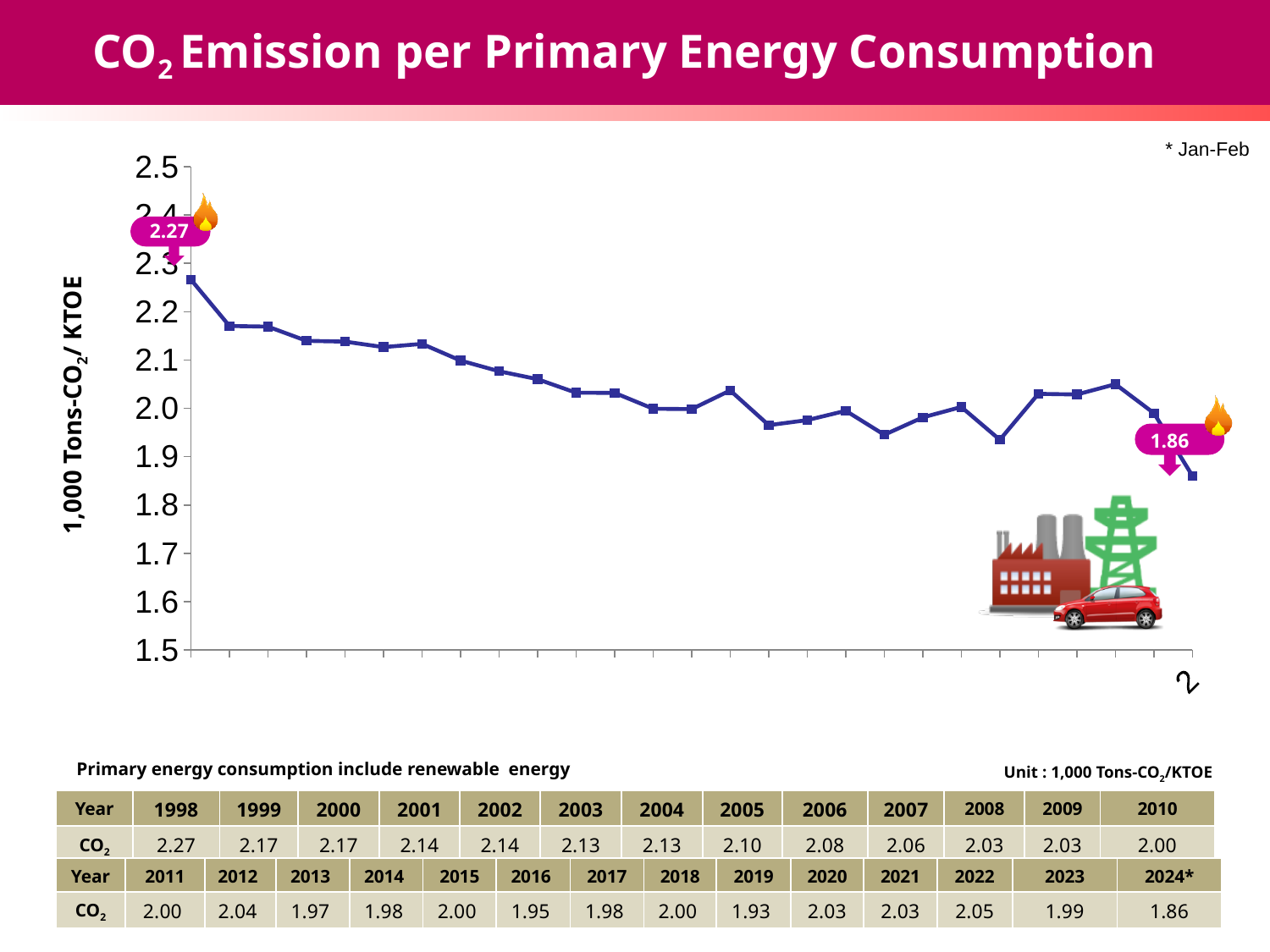
What is the difference between the 1998 value (2.27) and the 2024* value (1.86)? 0.41 Which is larger, the value for 2012 or the value for 2013? 2012 What is the value labelled at the end of the line (2024*)? 1.86 What is the CO2 value for 2005? 2.10 What kind of chart is shown on the slide? line chart Which year has the highest CO2 emission per primary energy consumption? 1998 Does the line generally rise or fall from 1998 to 2024? fall Is the value for 2019 greater or less than 2.0? less How many years (data points) are plotted on the chart? 27 What is the CO2 emission per primary energy consumption value labelled at the start of the line (1998)? 2.27 Which year has the lowest CO2 emission per primary energy consumption? 2024* What is the CO2 value for 2019 according to the table? 1.93